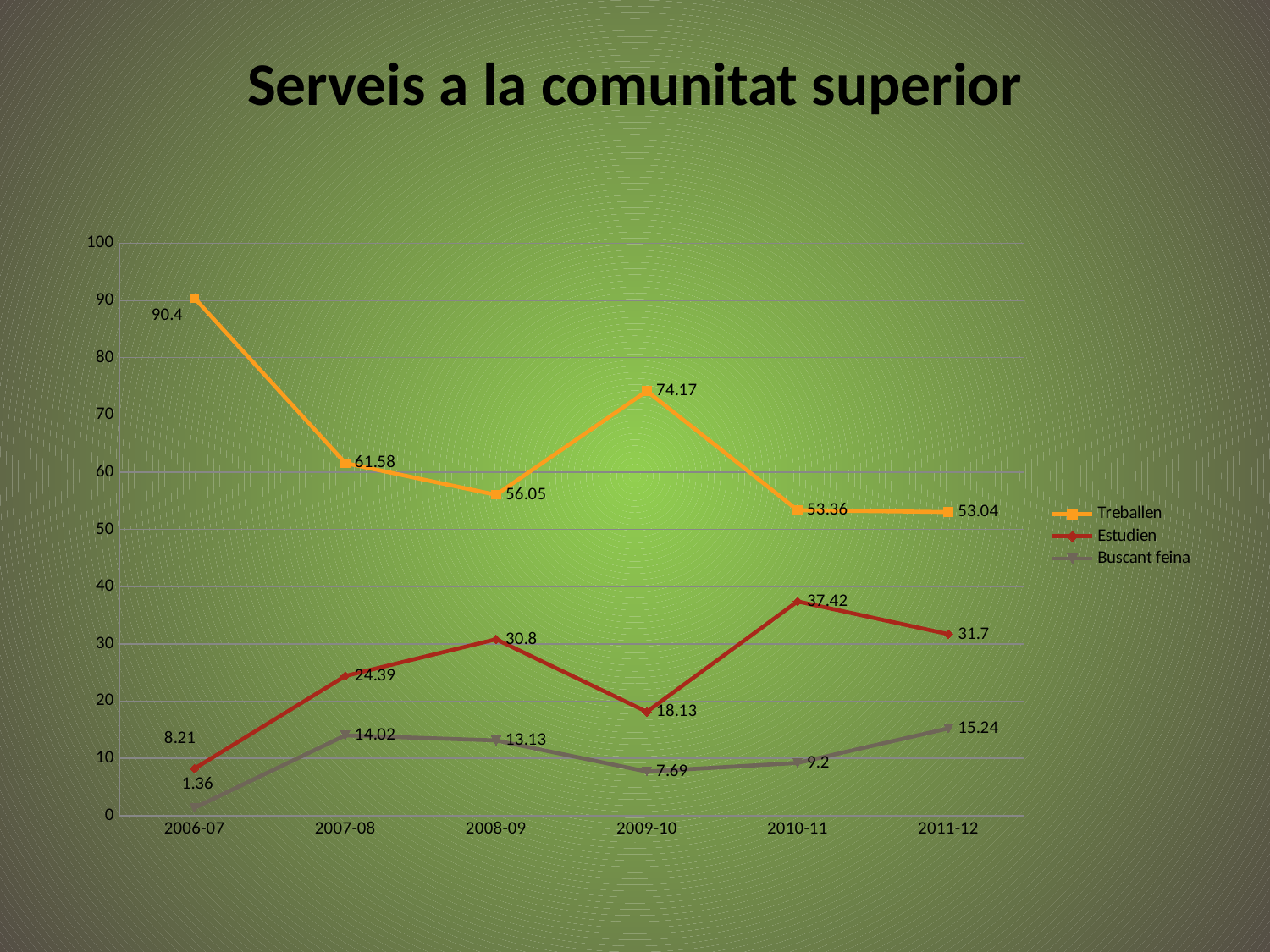
Which is larger in 2008-09, Estudien or Buscant feina? Estudien How many series does the legend list? 3 In which year is the Treballen series highest? 2006-07 How many years are shown on the x axis? 6 Is the value for Treballen in 2009-10 greater or less than 70? greater In which year is the Buscant feina series lowest? 2006-07 What is the value for Treballen in 2006-07? 90.4 What is the value for Estudien in 2010-11? 37.42 What is the value for Buscant feina in 2009-10? 7.69 What is the difference between Treballen and Estudien in 2011-12? 21.34 What kind of chart is shown on the slide? line chart What is the title of the chart? Serveis a la comunitat superior